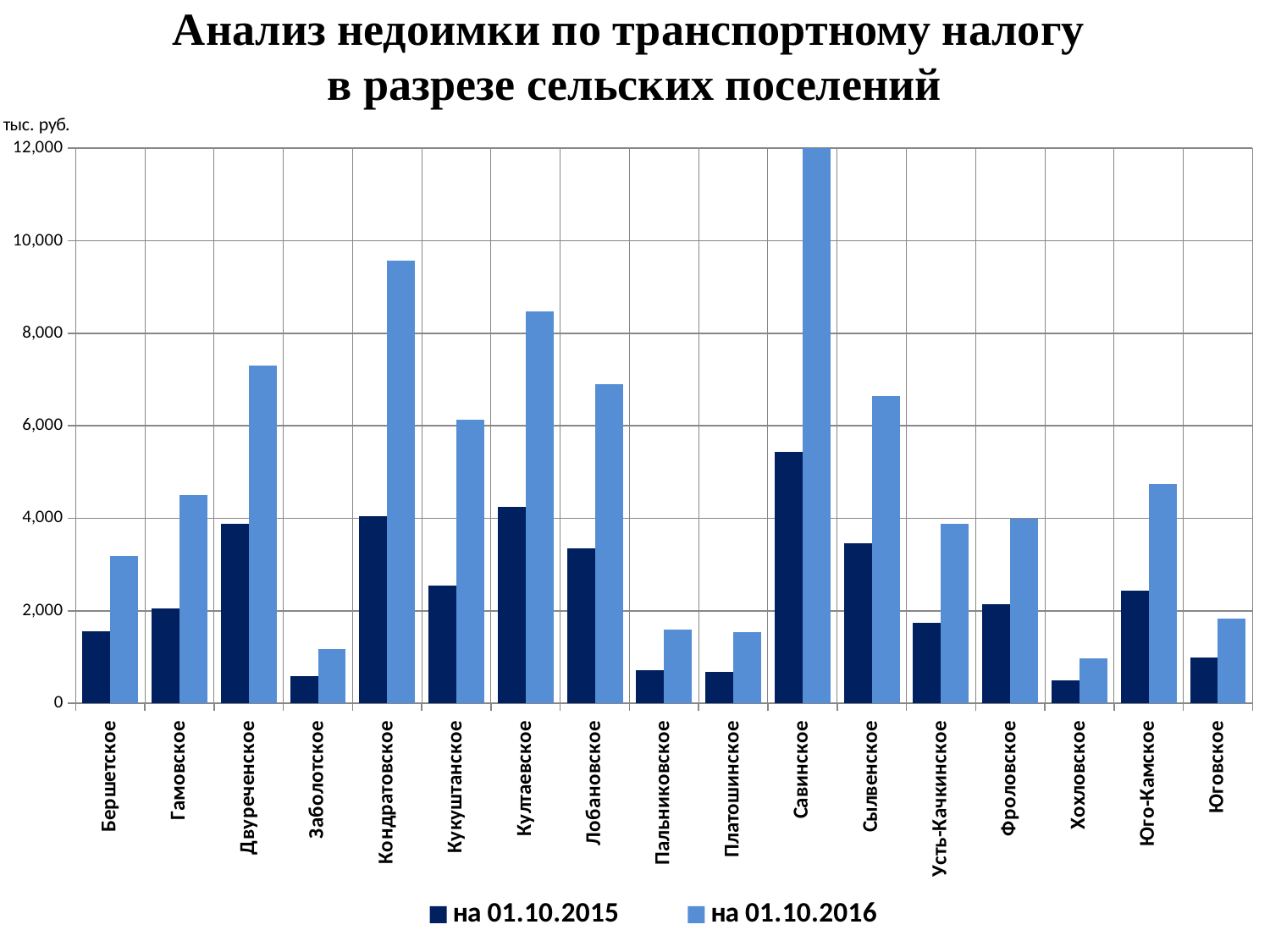
How many series does the legend list? 2 Is the value for Савинское на 01.10.2015 greater or less than 4,000? greater Which is larger for на 01.10.2015: Двуреченское or Гамовское? Двуреченское Which settlement has the highest value for на 01.10.2015? Савинское Which is larger for на 01.10.2016: Кондратовское or Култаевское? Кондратовское How many settlements (categories) are shown on the x axis? 17 What unit is indicated above the vertical axis? тыс. руб. What kind of chart is shown on the slide? bar chart Is the value for Двуреченское на 01.10.2016 greater or less than 6,000? greater Which settlement has the highest value for на 01.10.2016? Савинское Is the value for Бершетское на 01.10.2015 greater or less than 2,000? less